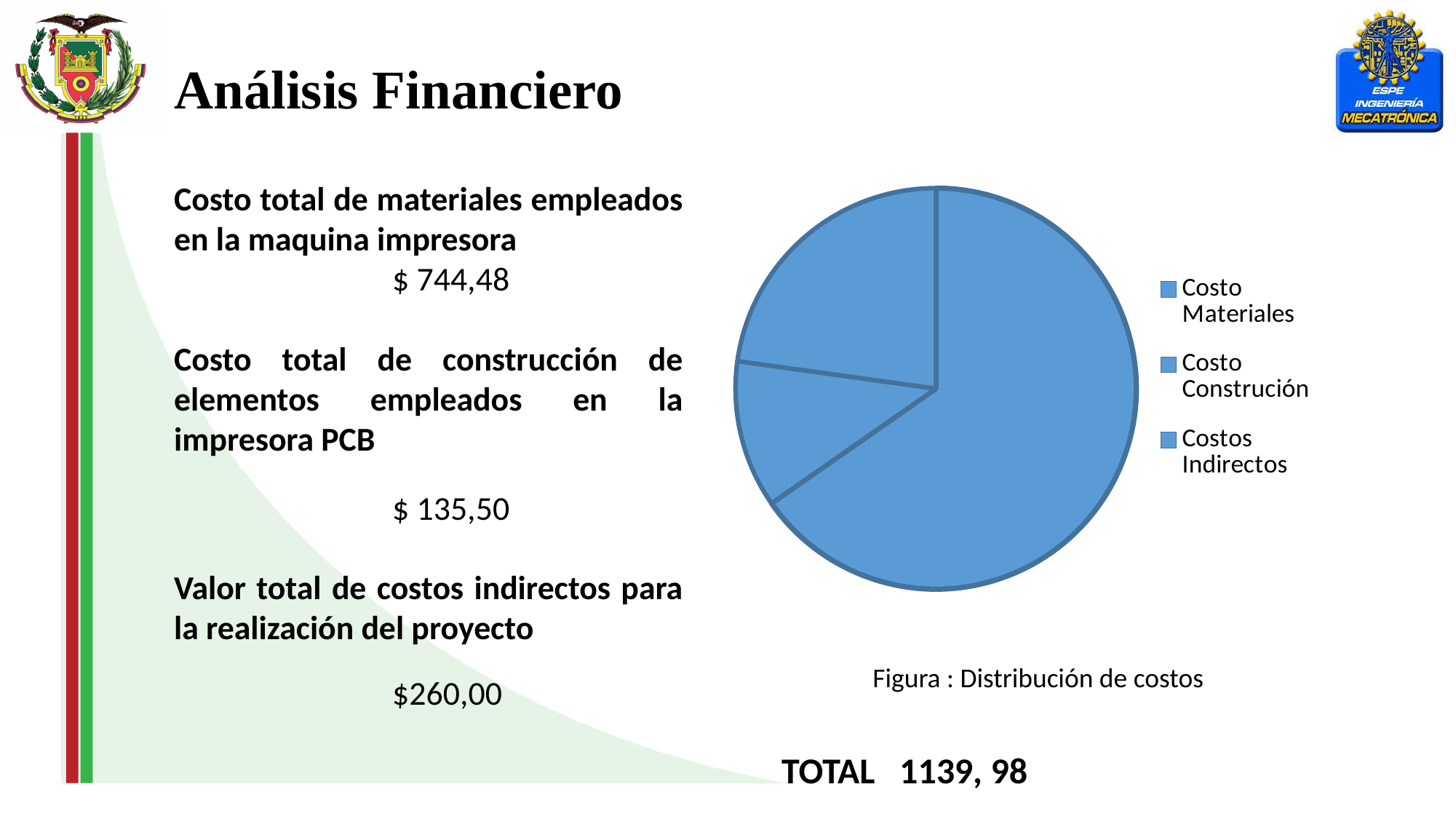
What are the three legend entries of the pie chart? Costo Materiales, Costo Construción, Costos Indirectos Which category has the smallest slice of the pie chart? Costo Construción Is the Costo Materiales slice greater or less than half of the pie? greater How many slices does the pie chart have? 3 What kind of chart is shown on the slide? pie chart Which category has the largest slice of the pie chart? Costo Materiales What total cost is printed on the slide for all three categories combined? 1139, 98 How many entries does the legend of the pie chart list? 3 What is the caption printed below the pie chart? Figura : Distribución de costos What is the cost value given on the slide for Costo Materiales? $ 744,48 Which is larger, the slice for Costos Indirectos or the slice for Costo Construción? Costos Indirectos What is the cost value given on the slide for Costos Indirectos? $260,00